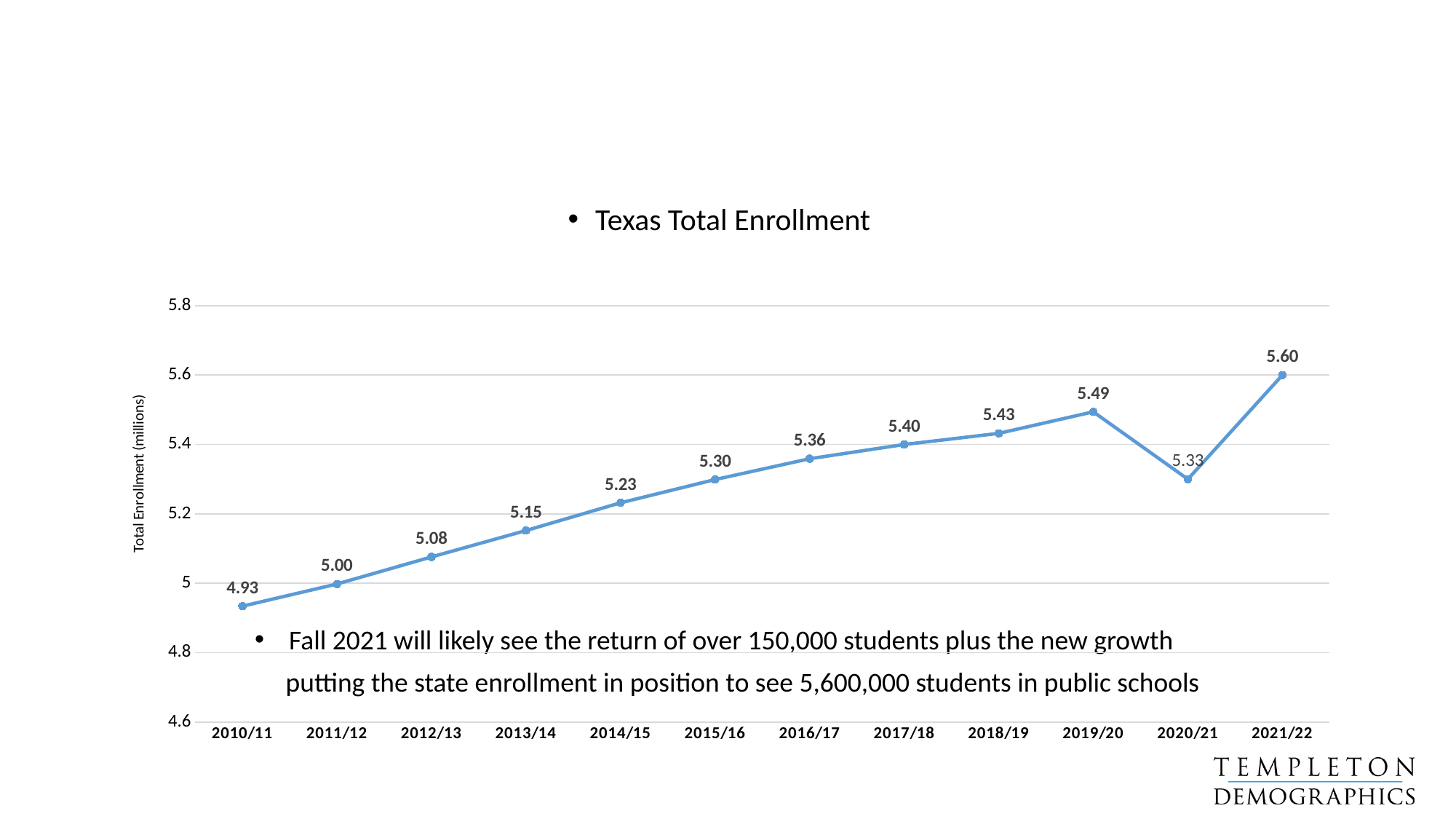
What is the total enrollment value for 2020/21? 5.33 What is the title of the chart? Texas Total Enrollment How many school years are plotted on the chart? 12 Which school year has the lowest total enrollment? 2010/11 Does total enrollment rise or fall from 2010/11 to 2019/20? rise What is the label on the vertical axis? Total Enrollment (millions) What is the total enrollment value for 2015/16? 5.30 Which is larger, the value for 2018/19 or the value for 2020/21? 2018/19 What is the difference between the 2019/20 value and the 2020/21 value? 0.16 Which school year has the highest total enrollment? 2021/22 What is the total enrollment value for 2010/11? 4.93 What kind of chart is shown on the slide? line chart